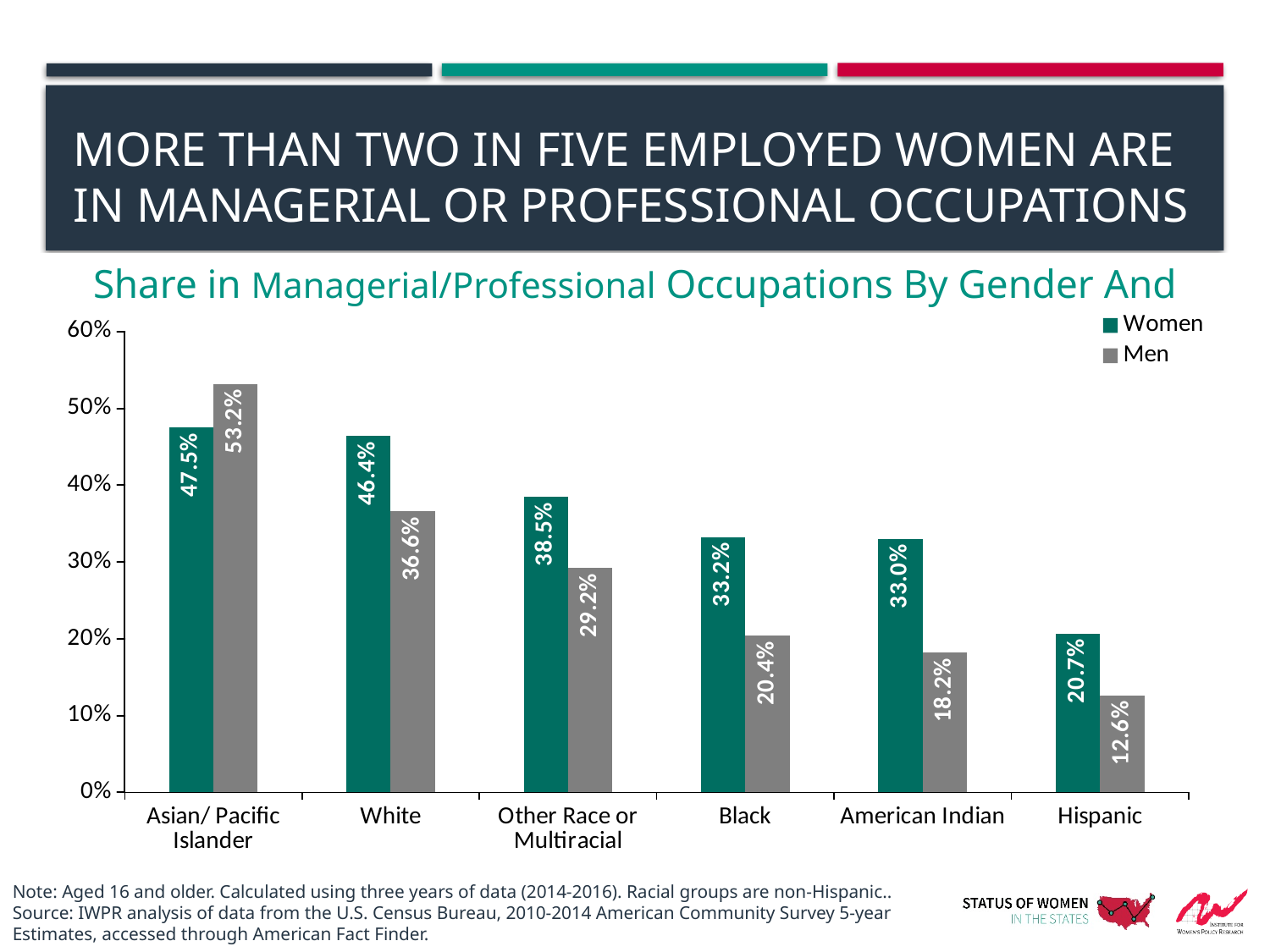
How many racial/ethnic categories are shown on the x axis? 6 In the Asian/ Pacific Islander category, which is larger, the value for Women or the value for Men? Men Which category has the highest value for Men? Asian/ Pacific Islander Which colour represents the Women series in the chart? teal (green) What is the value for Men in the Black category? 20.4% What is the value for Women in the Hispanic category? 20.7% What is the difference between the Women and Men values in the Other Race or Multiracial category? 9.3% What kind of chart is shown on the slide? bar chart Which category has the lowest value for Women? Hispanic What is the value for Women in the White category? 46.4% Is the value for Men in the American Indian category greater or less than 20%? less How many series does the legend list? 2